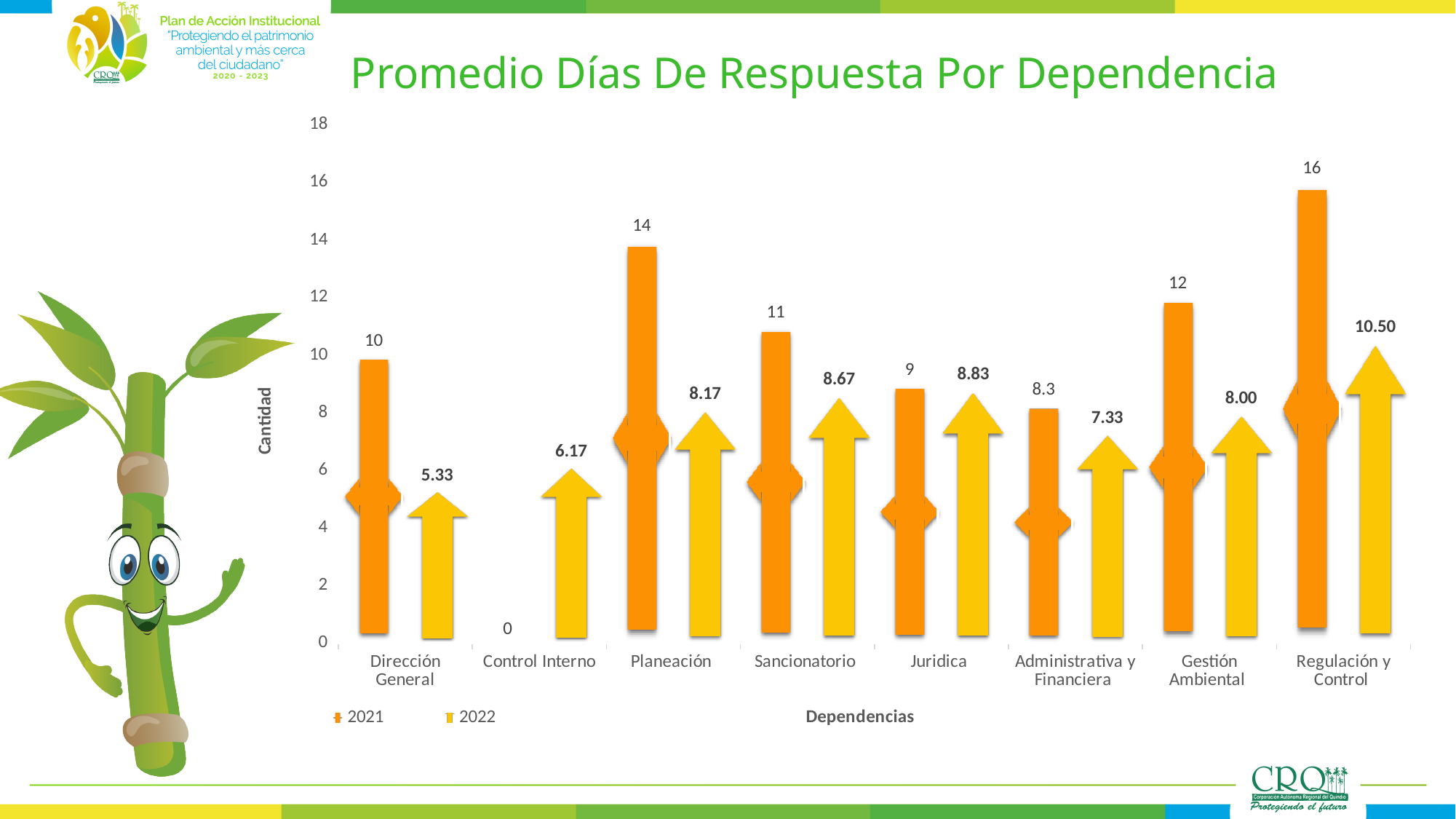
How many dependencias are shown on the x axis? 8 What is the difference between the 2021 and 2022 values for Gestión Ambiental? 4.00 What kind of chart is shown? bar chart Which dependencia has the lowest 2022 value? Dirección General Which is larger for Sancionatorio, the 2021 value or the 2022 value? 2021 Which dependencia has the highest 2021 value? Regulación y Control What is the 2021 value for Planeación? 14 What is the 2022 value for Regulación y Control? 10.50 What is the title of the chart? Promedio Días De Respuesta Por Dependencia How many series does the legend list? 2 What is the 2021 value for Administrativa y Financiera? 8.3 What is the 2022 value for Control Interno? 6.17